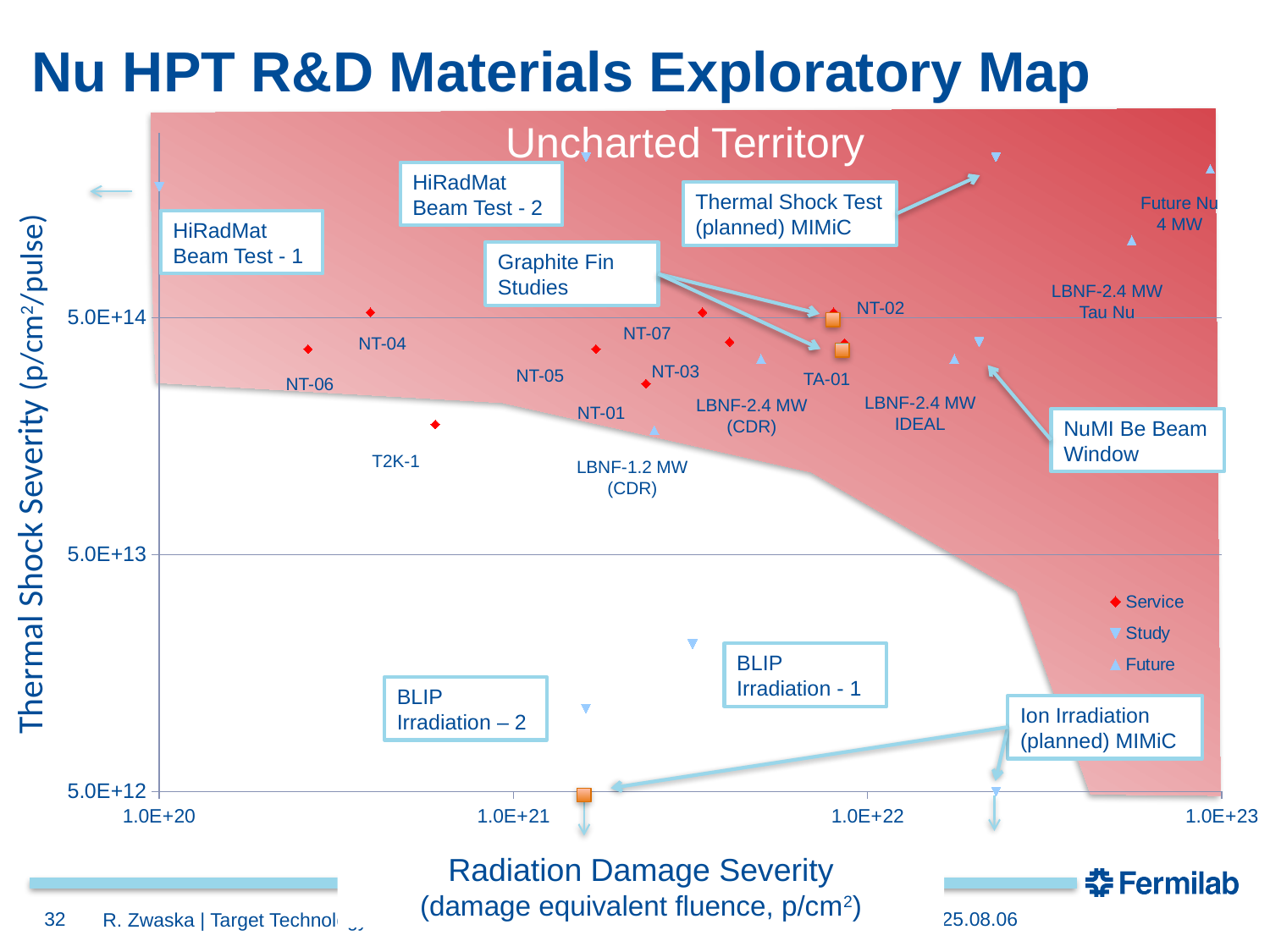
Which has the higher Radiation Damage Severity, Future Nu 4 MW or T2K-1? Future Nu 4 MW Is the Radiation Damage Severity value for Future Nu 4 MW greater or less than 1.0E+22? greater Which has the higher Thermal Shock Severity, NT-04 or T2K-1? NT-04 What kind of chart is shown on the slide? scatter chart What is the label of the vertical axis? Thermal Shock Severity (p/cm2/pulse) What are the three series named in the legend? Service, Study, Future Is the Thermal Shock Severity value for BLIP Irradiation - 1 greater or less than 5.0E+13? less Is the Radiation Damage Severity value for NT-02 greater or less than 1.0E+21? greater How many series does the chart legend list? 3 Which labeled point has the highest Radiation Damage Severity? Future Nu 4 MW